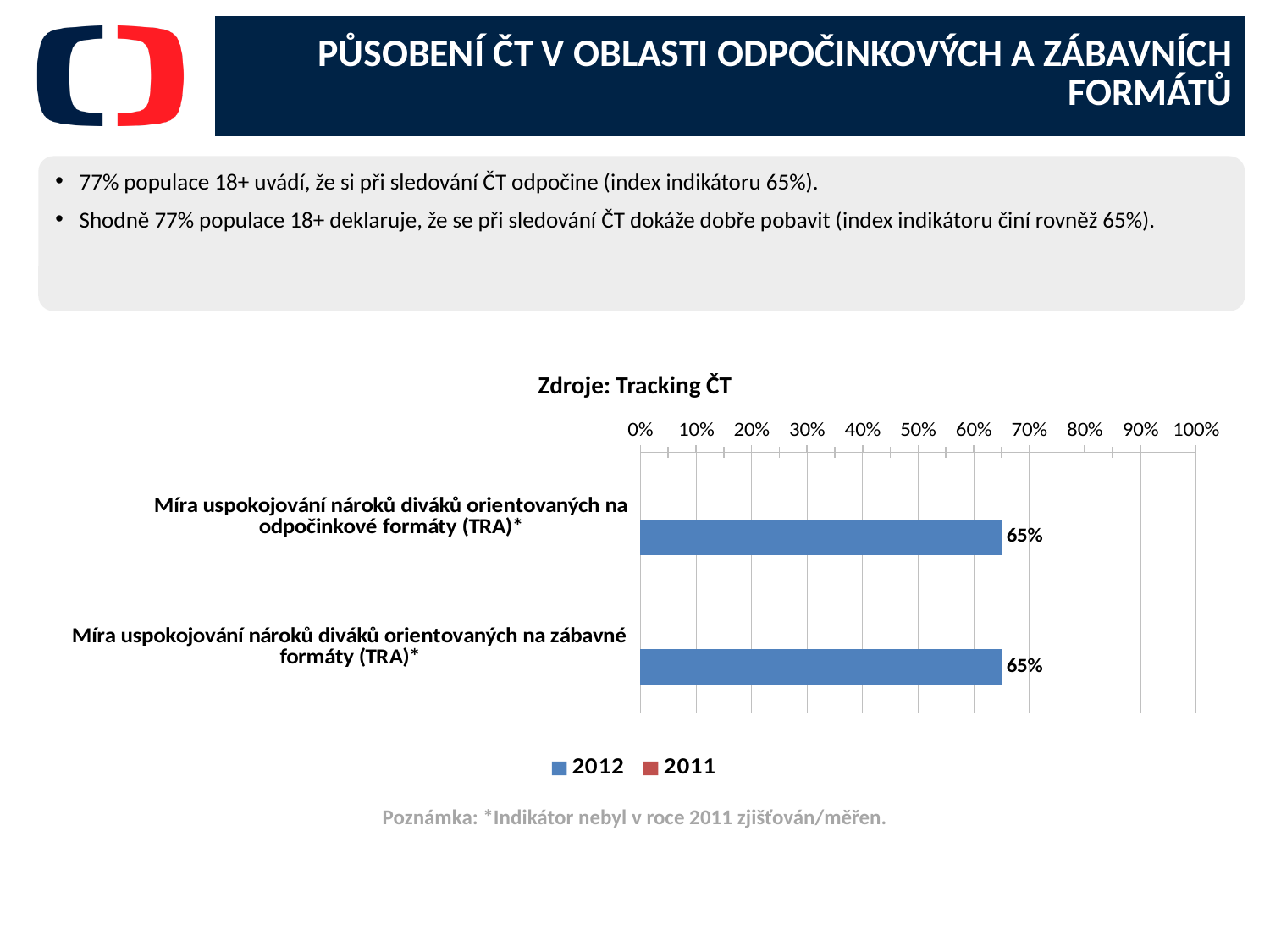
Which series are listed in the chart legend? 2012 and 2011 Is the 2012 value for 'Míra uspokojování nároků diváků orientovaných na zábavné formáty (TRA)*' greater or less than 60%? greater How many categories are shown on the chart? 2 What is the 2012 value for 'Míra uspokojování nároků diváků orientovaných na odpočinkové formáty (TRA)*'? 65% What colour are the bars for the 2012 series? blue What kind of chart is shown on the slide? bar chart What is the 2012 value for 'Míra uspokojování nároků diváků orientovaných na zábavné formáty (TRA)*'? 65% What is the highest value shown on the chart's x axis? 100% What is the difference between the 2012 values for the two categories on the chart? 0% Is the 2012 value for 'Míra uspokojování nároků diváků orientovaných na odpočinkové formáty (TRA)*' greater or less than 70%? less How many series does the legend list? 2